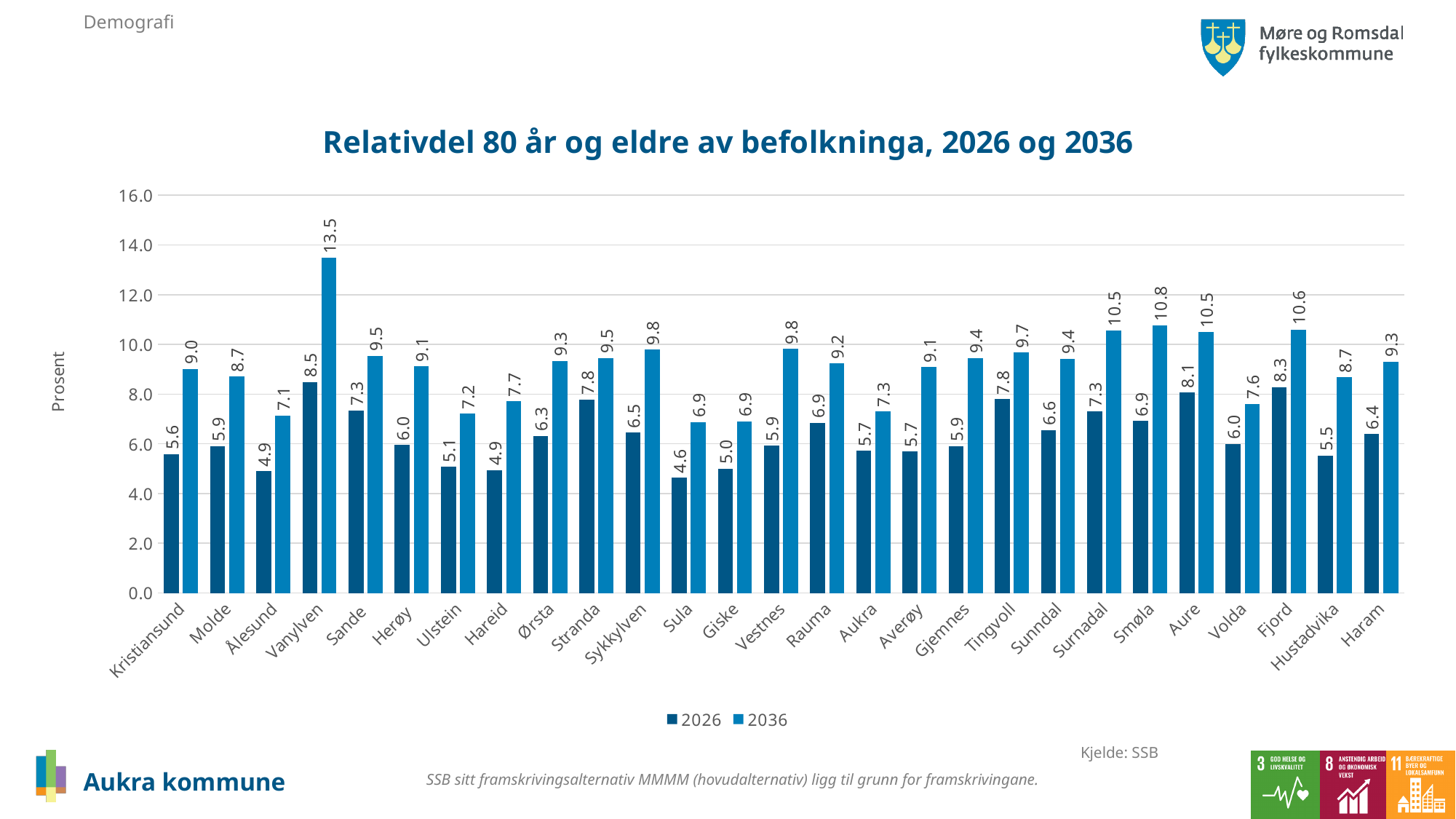
What is the difference between the 2036 and 2026 values for Aukra? 1.6 What is the 2026 value for Aukra? 5.7 What kind of chart is shown on the slide? Bar chart What is the 2036 value for Vanylven? 13.5 Which is larger, the 2026 value for Fjord or the 2026 value for Molde? Fjord How many series does the legend list? 2 What is the difference between the 2036 and 2026 values for Vanylven? 5.0 What is the 2036 value for Smøla? 10.8 How many municipalities are shown on the x axis? 27 Which municipality has the highest 2036 value? Vanylven Which municipality has the lowest 2026 value? Sula What is the title of the chart? Relativdel 80 år og eldre av befolkninga, 2026 og 2036